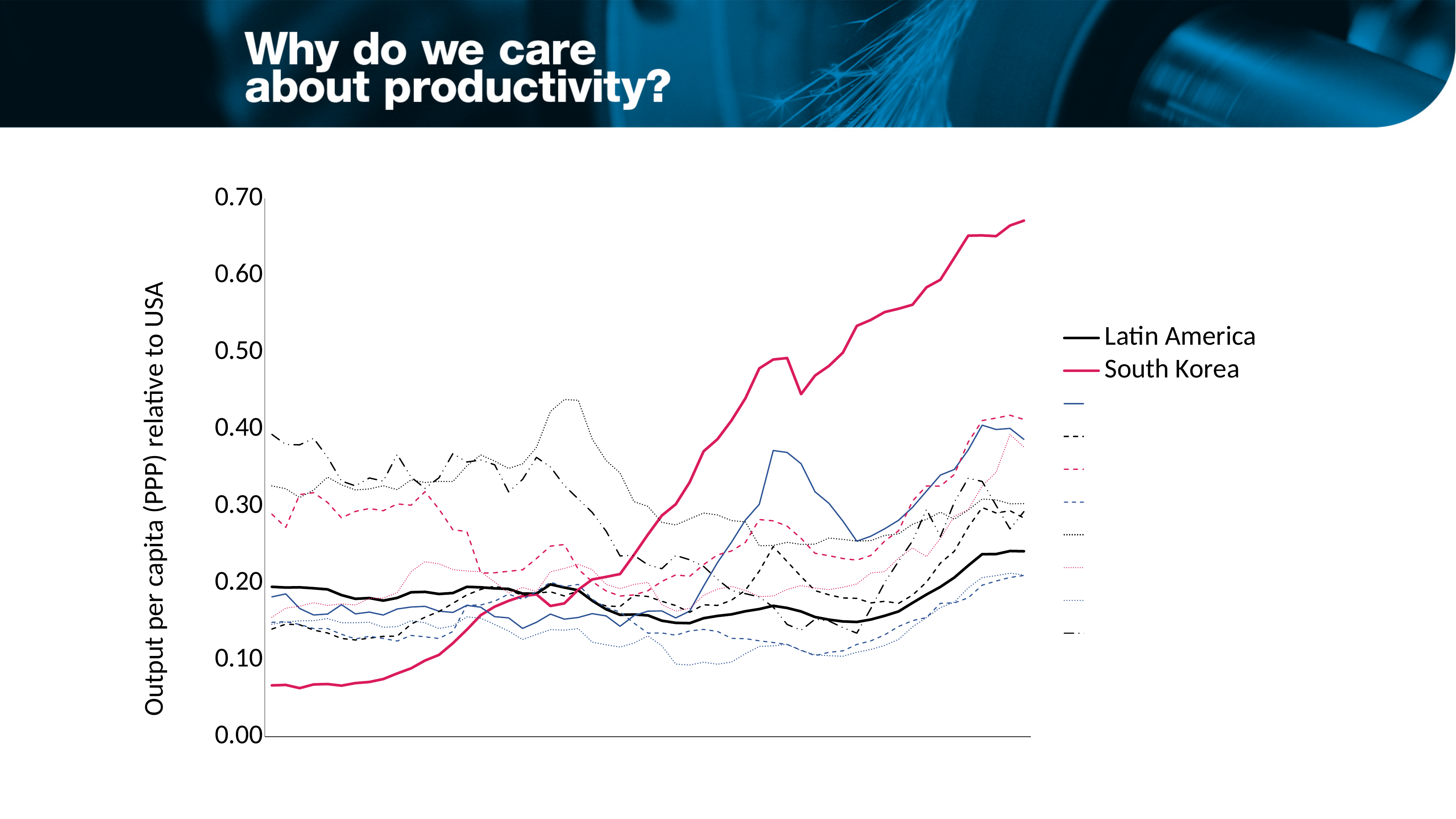
Does the South Korea line overall rise or fall from left to right? rise Is the final value of the Latin America line greater or less than 0.20? greater Is the starting value of the South Korea line greater or less than 0.10? less What kind of chart is shown on the slide? line chart How many named series does the legend list? 2 At the right end of the chart, which is higher: the South Korea line or the Latin America line? South Korea Is the final value of the Latin America line greater or less than 0.30? less What is the label of the vertical axis? Output per capita (PPP) relative to USA Which series reaches the highest value on the chart? South Korea At the left end of the chart, which is lower: the South Korea line or the Latin America line? South Korea Which two series are named in the legend? Latin America and South Korea